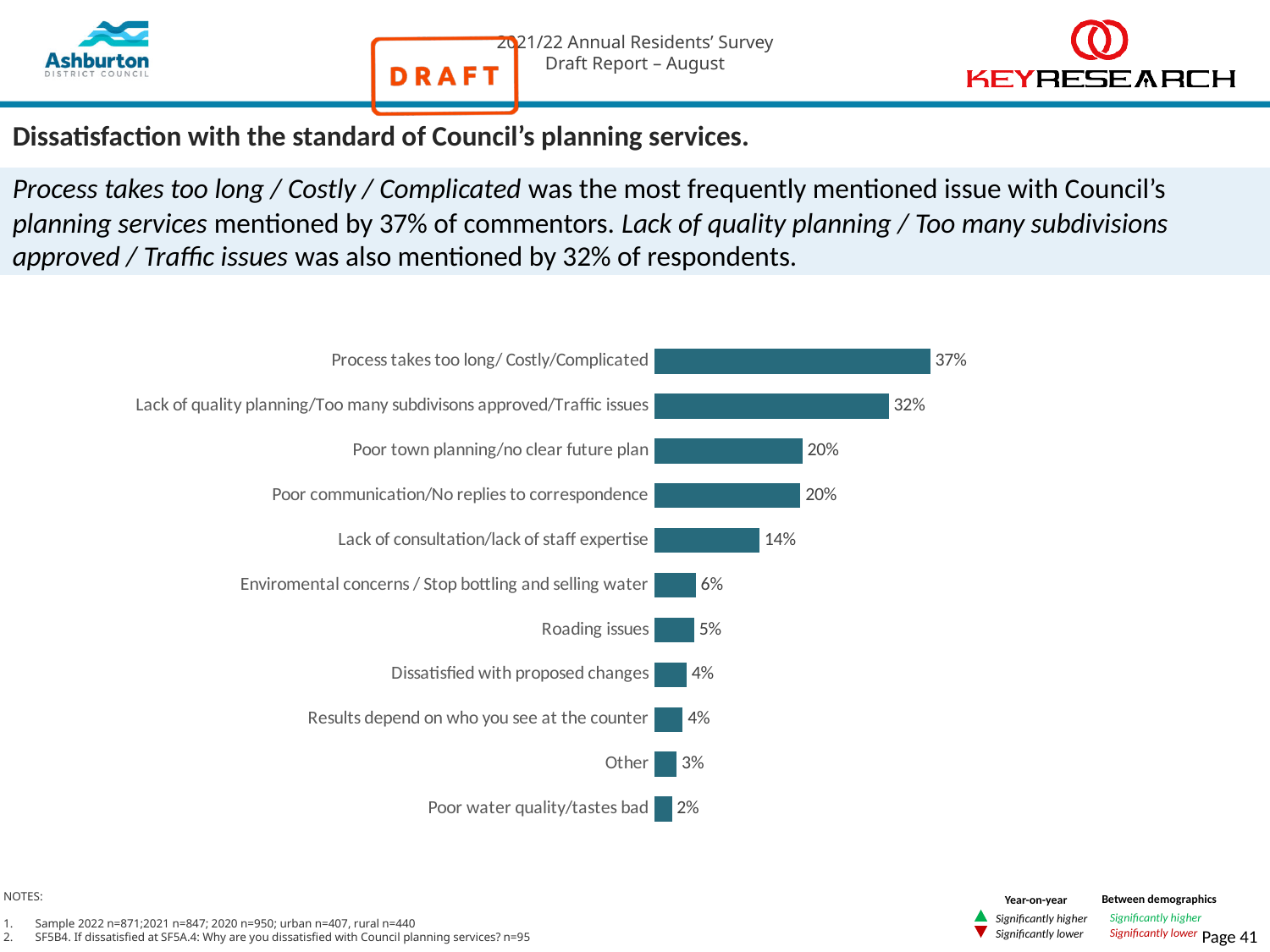
How many categories are shown in the bar chart? 11 What percentage is shown for "Lack of consultation/lack of staff expertise"? 14% What percentage is shown for "Other"? 3% What percentage is shown for "Process takes too long/ Costly/Complicated"? 37% What is the difference between the values for "Poor town planning/no clear future plan" and "Enviromental concerns / Stop bottling and selling water"? 14% What is the difference between the values for "Process takes too long/ Costly/Complicated" and "Lack of quality planning/Too many subdivisons approved/Traffic issues"? 5% Which category has the highest value in the chart? Process takes too long/ Costly/Complicated Which is larger, the value for "Lack of consultation/lack of staff expertise" or the value for "Roading issues"? Lack of consultation/lack of staff expertise Do the bar values increase or decrease from the top of the chart to the bottom? Decrease What type of chart is shown on the slide? Bar chart What percentage is shown for "Roading issues"? 5% Which category has the lowest value in the chart? Poor water quality/tastes bad